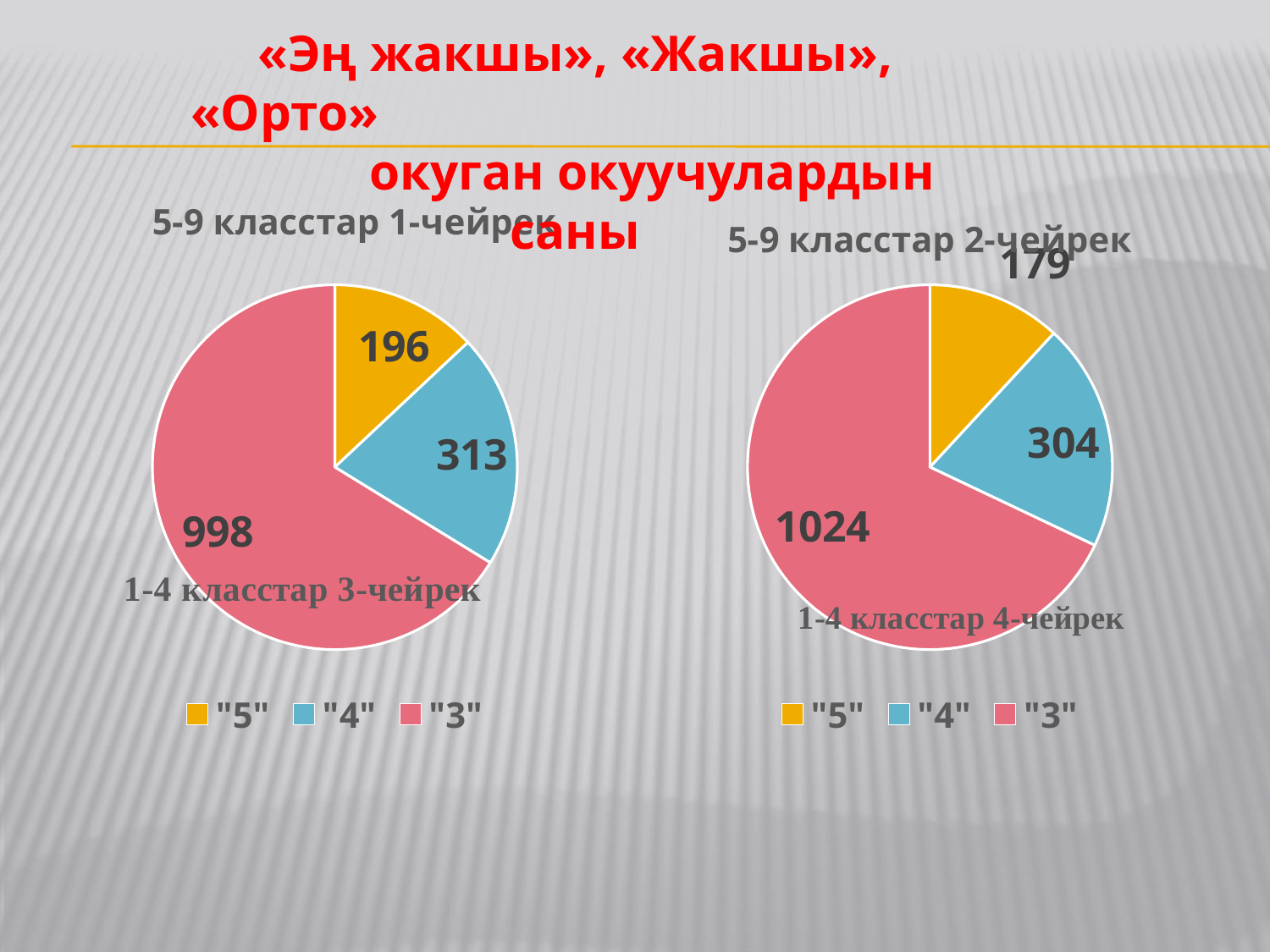
Which is larger: the "3" value in the "5-9 класстар 1-чейрек" chart or the "3" value in the "5-9 класстар 2-чейрек" chart? 5-9 класстар 2-чейрек In the chart titled "5-9 класстар 2-чейрек", which category has the smallest slice? "5" In the chart titled "5-9 класстар 2-чейрек", what is the value for the "5" slice? 179 In the chart titled "5-9 класстар 1-чейрек", what is the value for the "5" slice? 196 In the chart titled "5-9 класстар 1-чейрек", what is the difference between the "4" and "5" values? 117 In the chart titled "5-9 класстар 1-чейрек", which category has the largest slice? "3" In the chart titled "5-9 класстар 1-чейрек", what colour is the "4" slice? blue How many slices does the chart titled "5-9 класстар 1-чейрек" have? 3 In the chart titled "5-9 класстар 2-чейрек", what is the difference between the "3" and "4" values? 720 In the chart titled "5-9 класстар 2-чейрек", what is the value for the "3" slice? 1024 In the chart titled "5-9 класстар 1-чейрек", what is the value for the "4" slice? 313 What type of chart is the one titled "5-9 класстар 2-чейрек"? pie chart